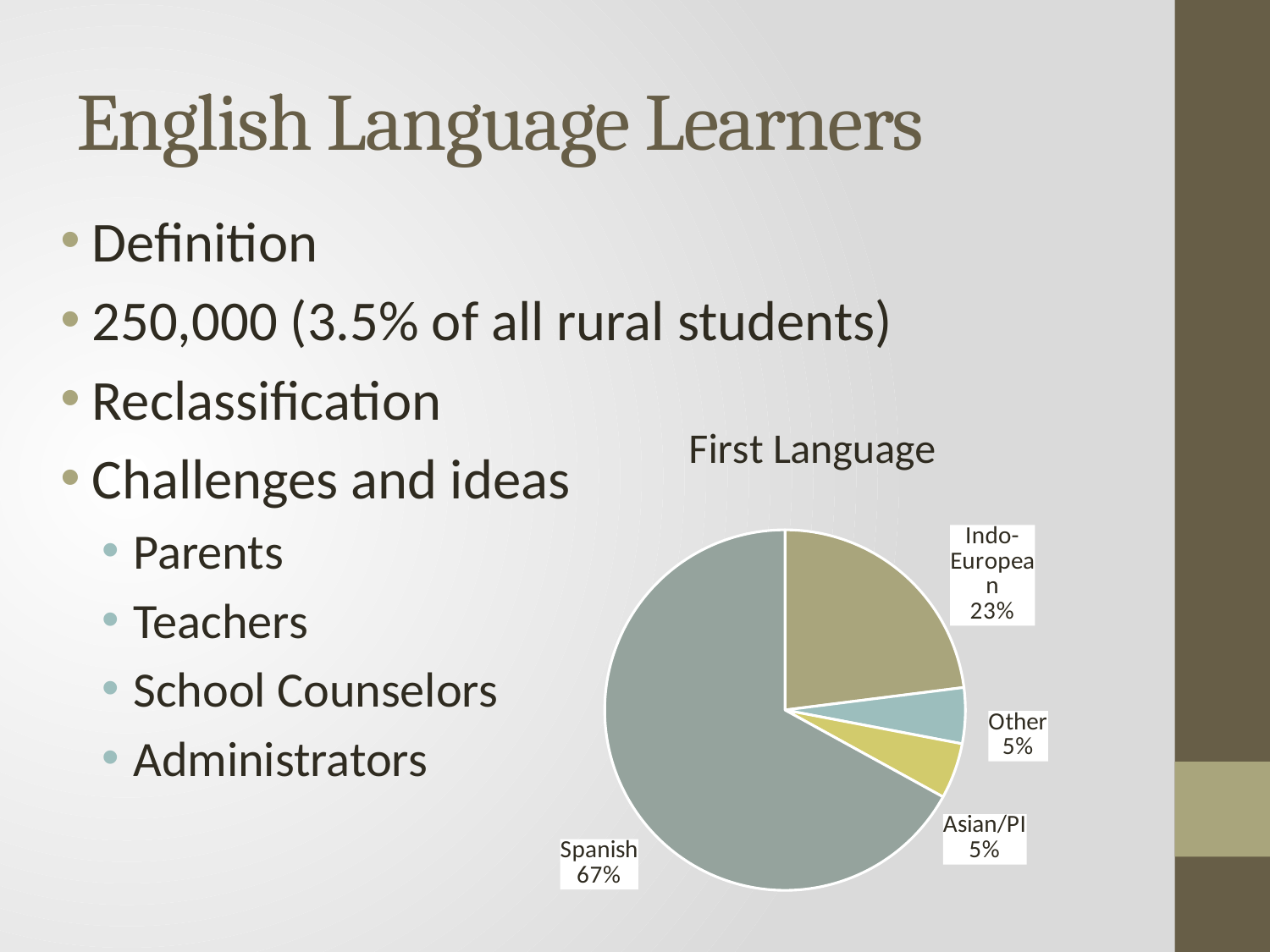
What is the difference in percentage points between Spanish and Indo-European? 44 Which first language has the largest slice of the pie? Spanish Which is larger, the Indo-European slice or the Asian/PI slice? Indo-European Which slice of the pie is coloured the darkest grey-green and is the largest? Spanish What share of the pie does Spanish represent? 67% How many slices does the pie chart have? 4 What is the title of the chart? First Language What is the difference in percentage points between Indo-European and Other? 18 What percentage is shown for Other? 5% What percentage is shown for Asian/PI? 5% What type of chart is shown on the slide? Pie chart What percentage is shown for Indo-European? 23%